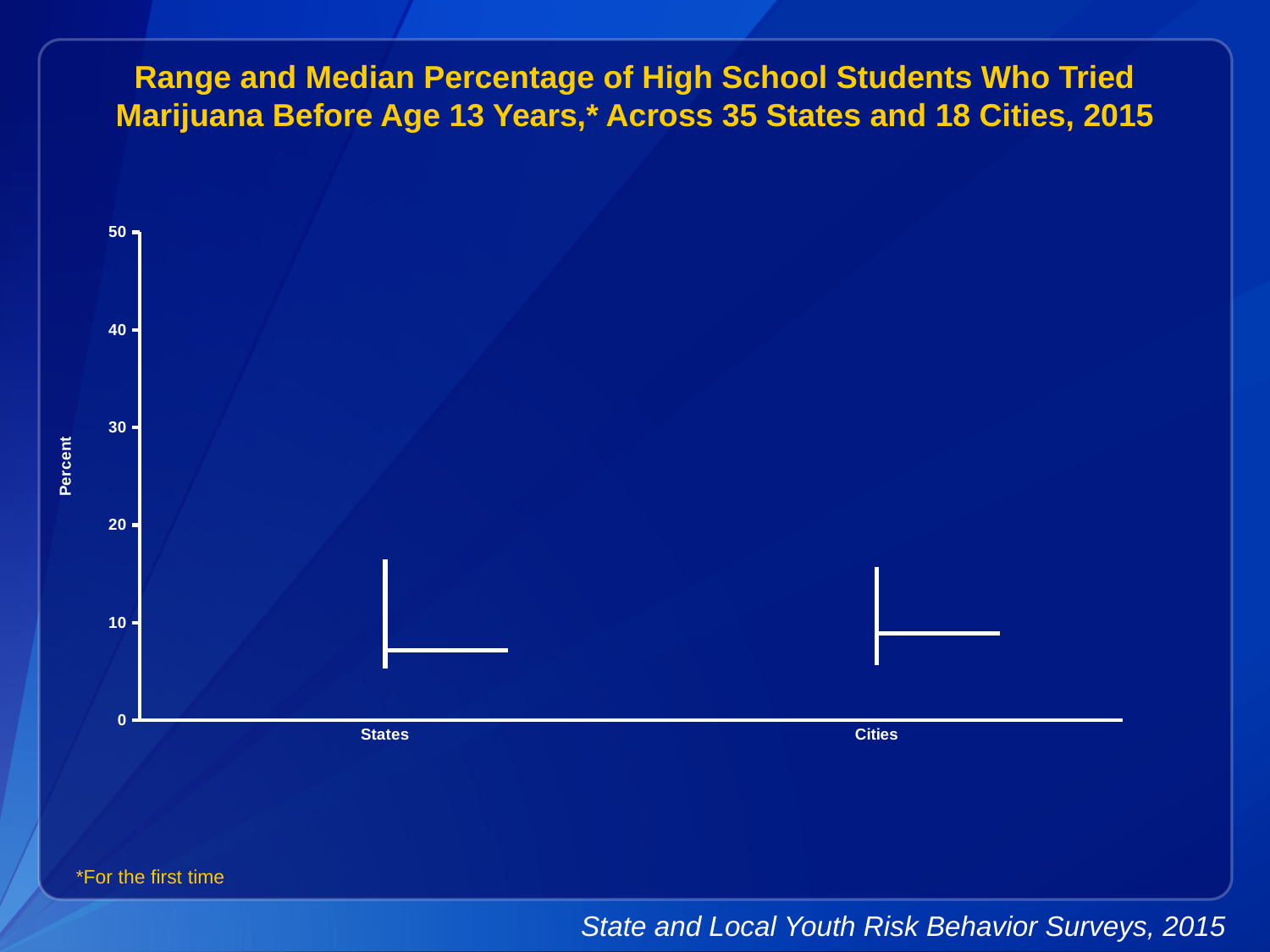
What is the highest value shown on the y axis? 50 Is the median value for States greater or less than 10? less How many categories are shown on the x axis of the chart? 2 Is the top of the range for States greater or less than 20? less What are the two categories shown on the x axis? States and Cities Is the top of the range for Cities greater or less than 20? less Which category has the higher median value, States or Cities? Cities What is the label of the y axis? Percent